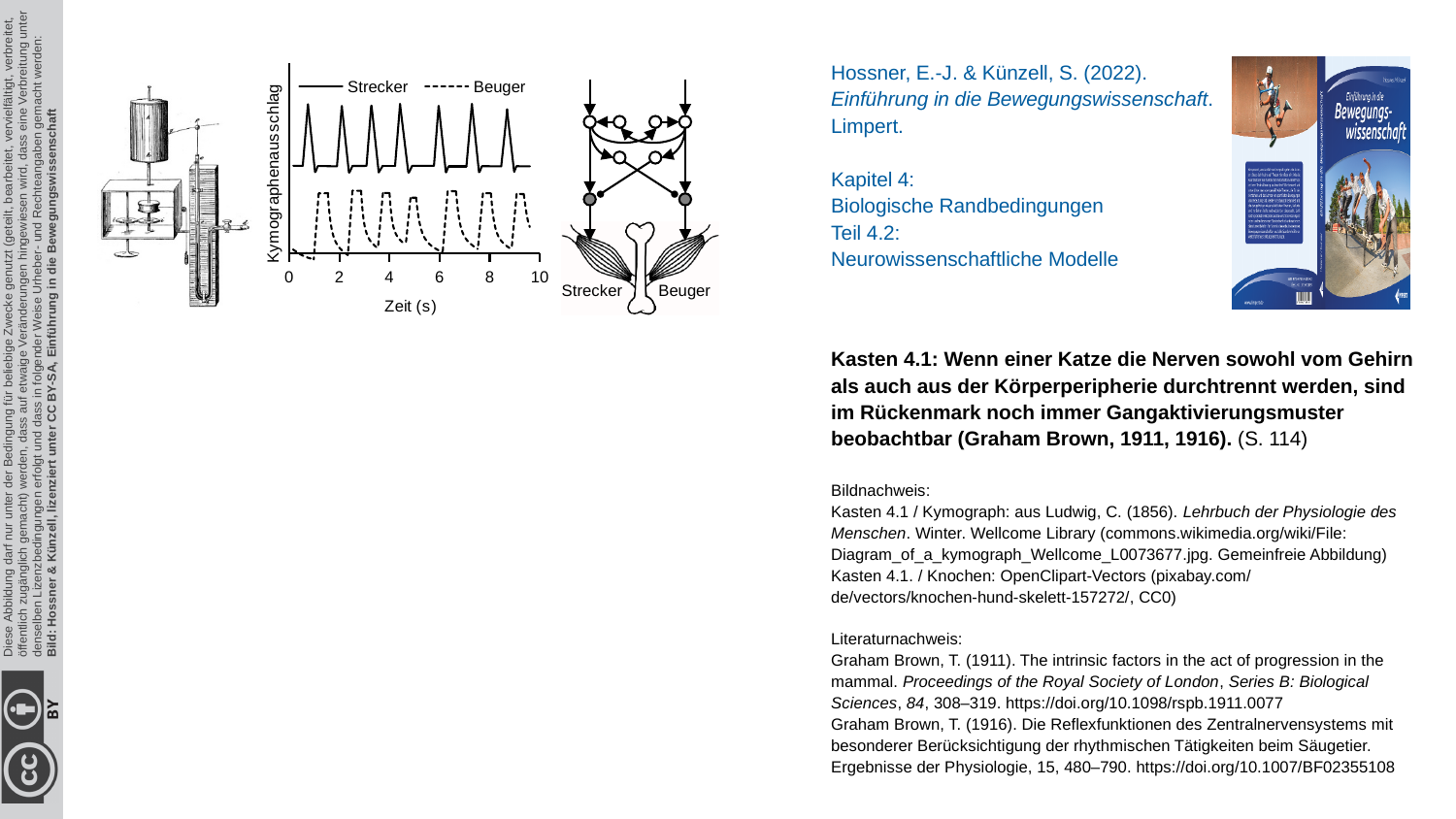
What are the two series named in the chart's legend? Strecker and Beuger How many series does the chart's legend list? 2 What is the highest tick value shown on the x axis of the chart? 10 What is the label of the x axis of the chart? Zeit (s) What kind of chart is shown on the slide? line chart